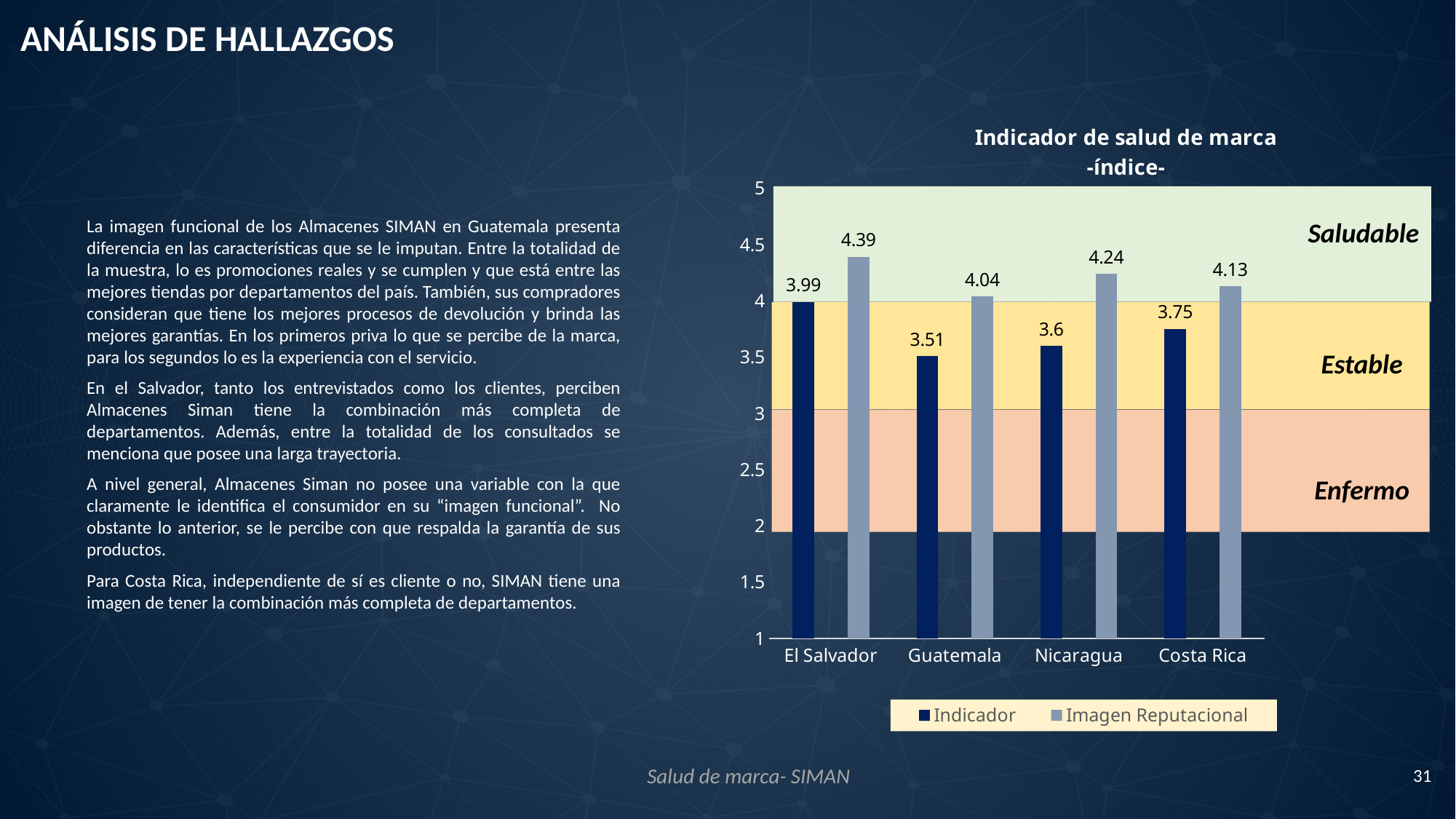
What is the Indicador value for Costa Rica? 3.75 Is the Indicador value for Nicaragua greater or less than 4? less How many countries are shown on the x axis? 4 What kind of chart is shown on the slide? bar chart How many series does the legend list? 2 What is the Imagen Reputacional value for Nicaragua? 4.24 What is the difference between the Imagen Reputacional and Indicador values for Guatemala? 0.53 Which is larger for Costa Rica, the Indicador value or the Imagen Reputacional value? Imagen Reputacional What is the Indicador value for El Salvador? 3.99 Which country has the lowest Indicador value? Guatemala What are the three zone labels shown on the right side of the chart, from top to bottom? Saludable, Estable, Enfermo Which country has the highest Imagen Reputacional value? El Salvador